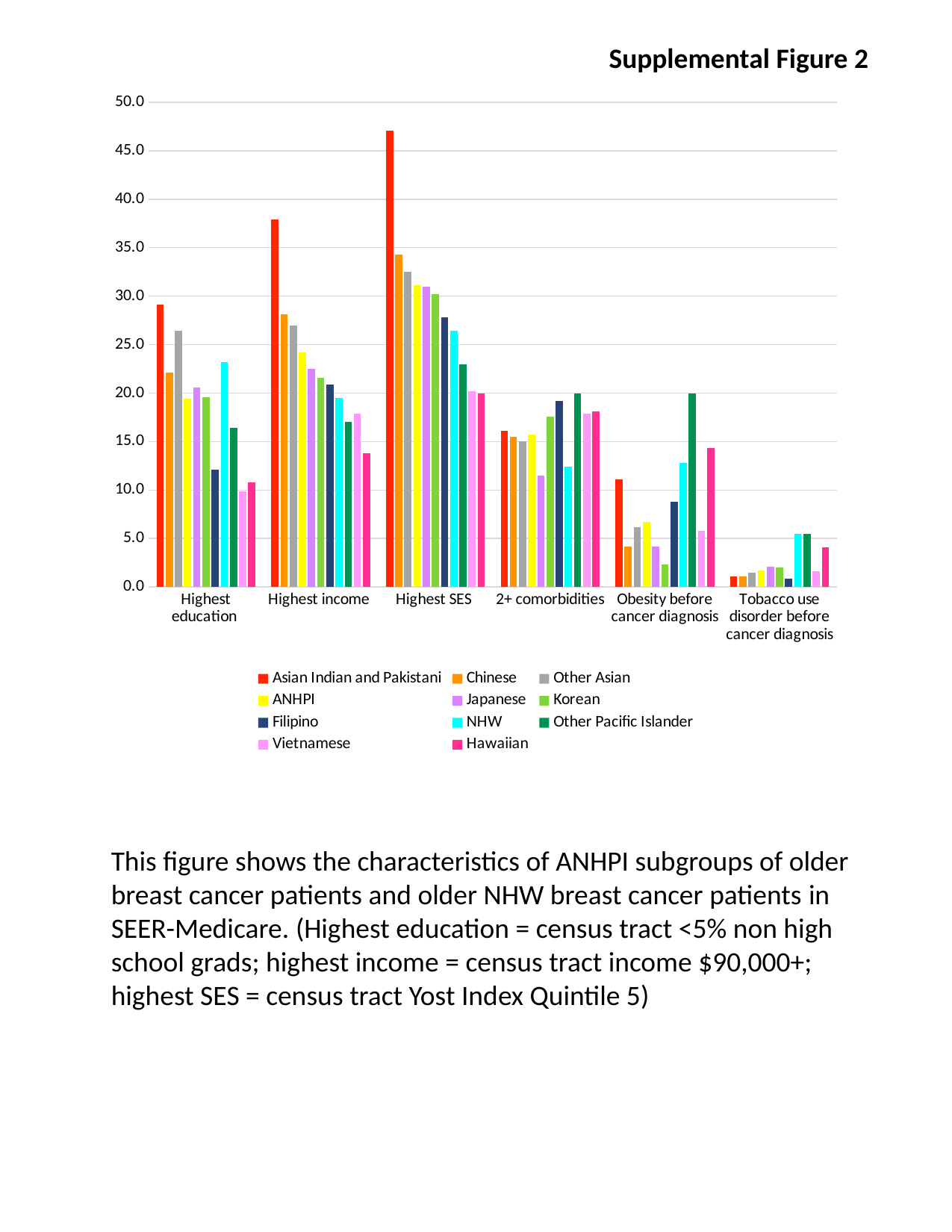
In the Highest income category, which group has the lowest value? Hawaiian What kind of chart is shown on the slide? bar chart In the Highest education category, which is larger: Other Asian or Filipino? Other Asian Is the value for Asian Indian and Pakistani in the Highest income category greater or less than 35.0? greater Is the value for Asian Indian and Pakistani in the Highest SES category greater or less than 45.0? greater Is the value for Filipino in the Highest education category greater or less than 15.0? less How many series does the legend list? 11 In the Obesity before cancer diagnosis category, which group has the highest value? Other Pacific Islander How many categories are shown along the x axis? 6 In the Highest SES category, which group has the highest value? Asian Indian and Pakistani In the Obesity before cancer diagnosis category, which is larger: NHW or Filipino? NHW What is the title shown above the chart? Supplemental Figure 2